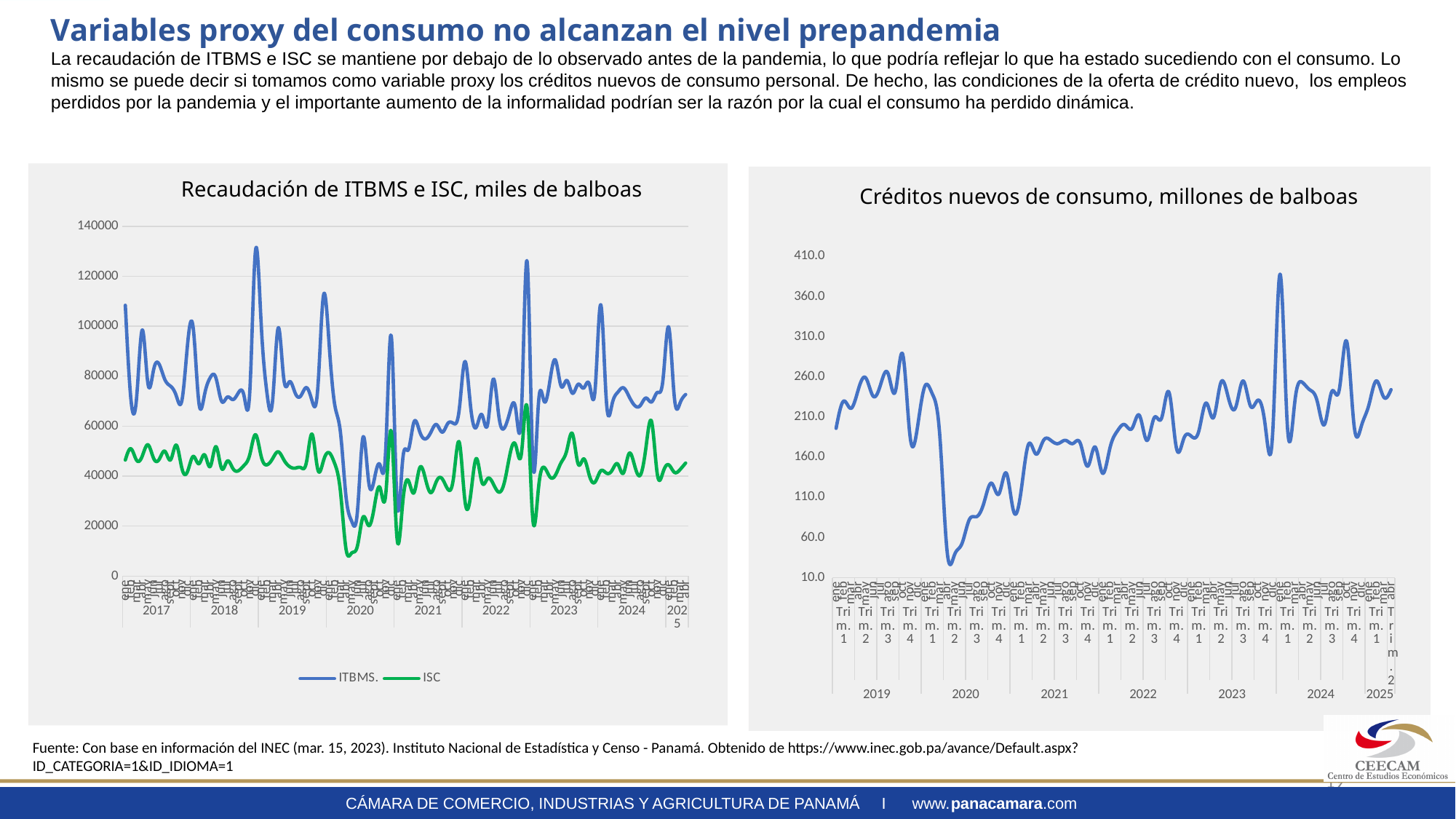
In the chart 'Recaudación de ITBMS e ISC, miles de balboas', is the lowest ISC value in 2020 greater or less than 20000? less In the chart 'Recaudación de ITBMS e ISC, miles de balboas', in which year does the ISC series reach its lowest point? 2020 In the chart 'Créditos nuevos de consumo, millones de balboas', is the highest peak in 2024 greater or less than 360.0? greater How many year labels appear on the x axis of the chart 'Recaudación de ITBMS e ISC, miles de balboas'? 9 How many series does the legend of the chart 'Recaudación de ITBMS e ISC, miles de balboas' list? 2 In the chart 'Créditos nuevos de consumo, millones de balboas', is the lowest value in 2020 greater or less than 60.0? less In the chart 'Recaudación de ITBMS e ISC, miles de balboas', which series has the higher values throughout the period, ITBMS or ISC? ITBMS What kind of chart is 'Recaudación de ITBMS e ISC, miles de balboas'? line chart What is the unit stated in the title of the right-hand chart? millones de balboas What kind of chart is 'Créditos nuevos de consumo, millones de balboas'? line chart In the chart 'Recaudación de ITBMS e ISC, miles de balboas', which series is plotted in green? ISC